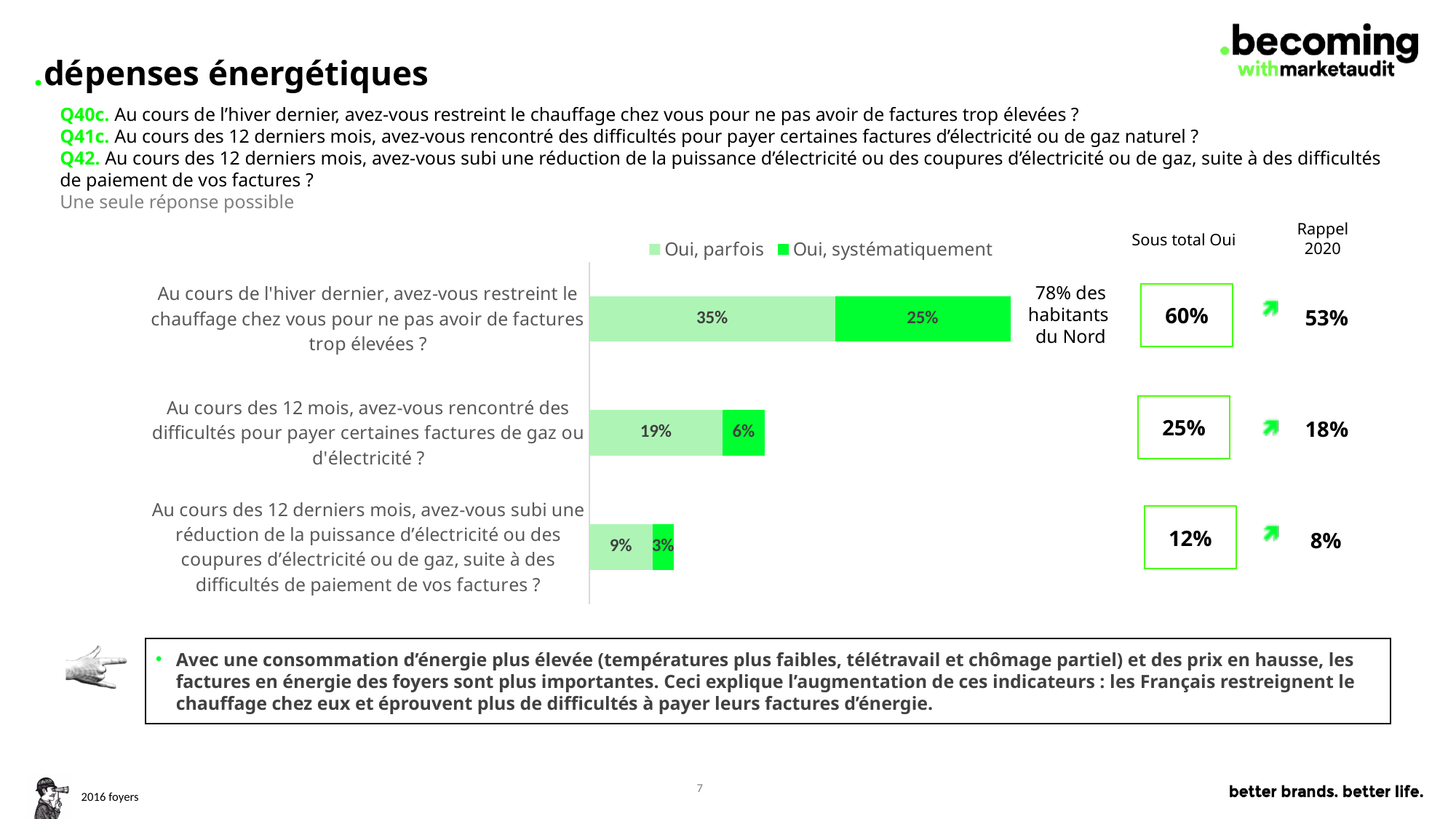
What is the difference between the 'Oui, parfois' and 'Oui, systématiquement' values for the question about difficulties paying gas or electricity bills? 13% What type of chart is shown on the slide? Stacked bar chart What is the 'Oui, parfois' value for the question about restricting heating last winter to avoid high bills? 35% How many categories (questions) are plotted in the chart? 3 What is the total 'Oui' (sous total Oui) for the question about restricting heating last winter? 60% Which question has the lowest 'Oui, parfois' value? Au cours des 12 derniers mois, avez-vous subi une réduction de la puissance d'électricité ou des coupures d'électricité ou de gaz, suite à des difficultés de paiement de vos factures ? Is the 'Oui, parfois' value larger for the question about restricting heating or for the question about difficulties paying bills? Restricting heating (35%) What was the 'Rappel 2020' value for the question about suffering a power reduction or cut-off? 8% What is the 'Oui, parfois' value for the question about suffering a power reduction or cut-off due to payment difficulties? 9% Which question has the highest 'Oui, systématiquement' value? Au cours de l'hiver dernier, avez-vous restreint le chauffage chez vous pour ne pas avoir de factures trop élevées ? How many series does the chart legend list? 2 What is the 'Oui, systématiquement' value for the question about difficulties paying gas or electricity bills in the last 12 months? 6%